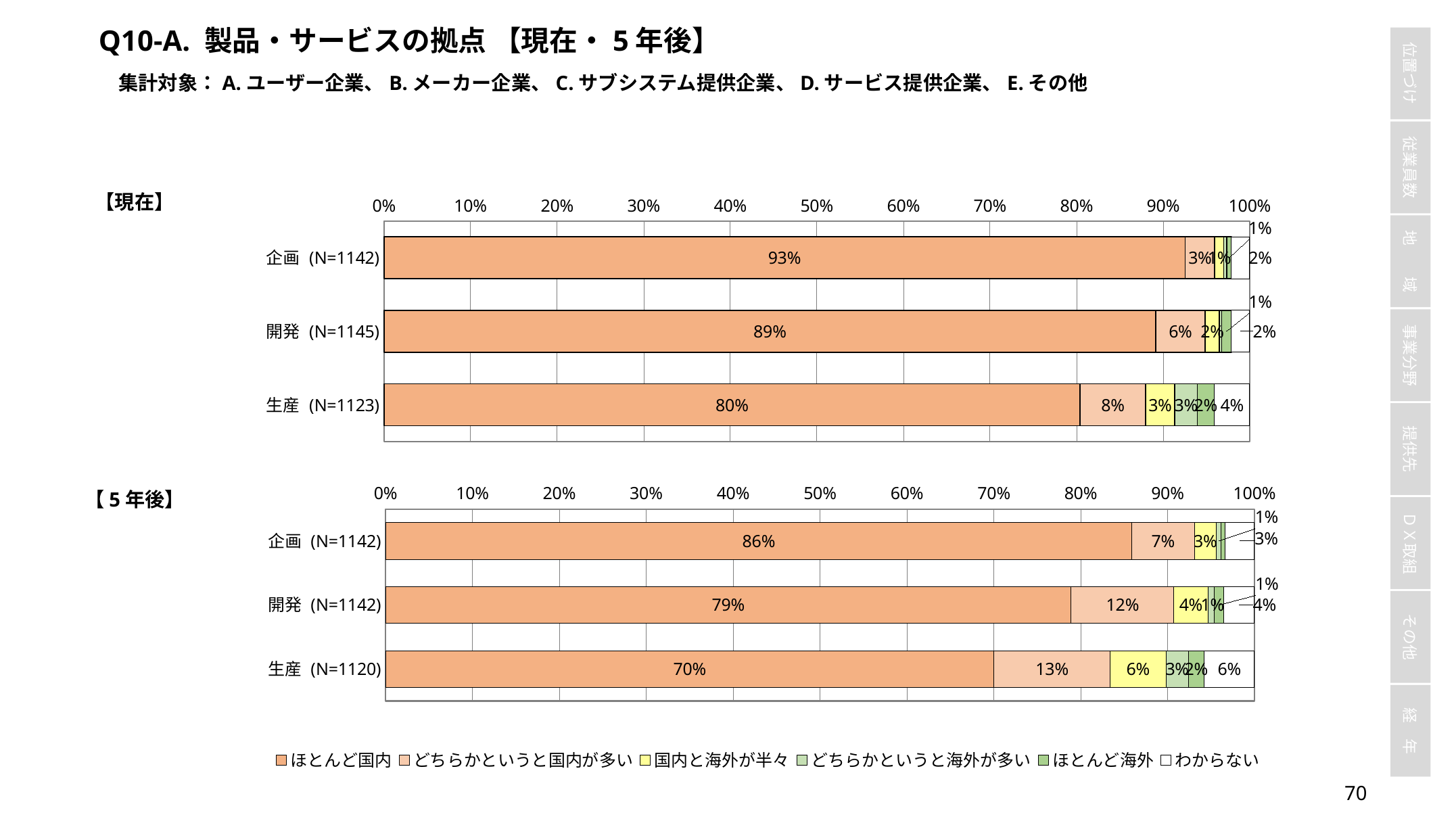
How many series does the legend list? 6 In the 【5年後】 chart, what is the value for どちらかというと国内が多い for 開発 (N=1142)? 12% In the 【現在】 chart, what is the value for ほとんど国内 for 企画 (N=1142)? 93% How many categories are shown in the 【現在】 chart? 3 What is the difference between the ほとんど国内 value for 生産 in the 【現在】 chart (80%) and in the 【5年後】 chart (70%)? 10% In the 【5年後】 chart, which is larger: the ほとんど国内 value for 企画 or for 開発? 企画 What kind of chart is the 【5年後】 chart? Stacked bar chart In the 【現在】 chart, which category has the highest value for ほとんど国内? 企画 (N=1142) In the 【現在】 chart, what is the value for どちらかというと国内が多い for 生産 (N=1123)? 8% In the 【5年後】 chart, which category has the lowest value for ほとんど国内? 生産 (N=1120) In the 【5年後】 chart, what is the value for ほとんど国内 for 生産 (N=1120)? 70% In the 【5年後】 chart, what is the value for 国内と海外が半々 for 生産 (N=1120)? 6%